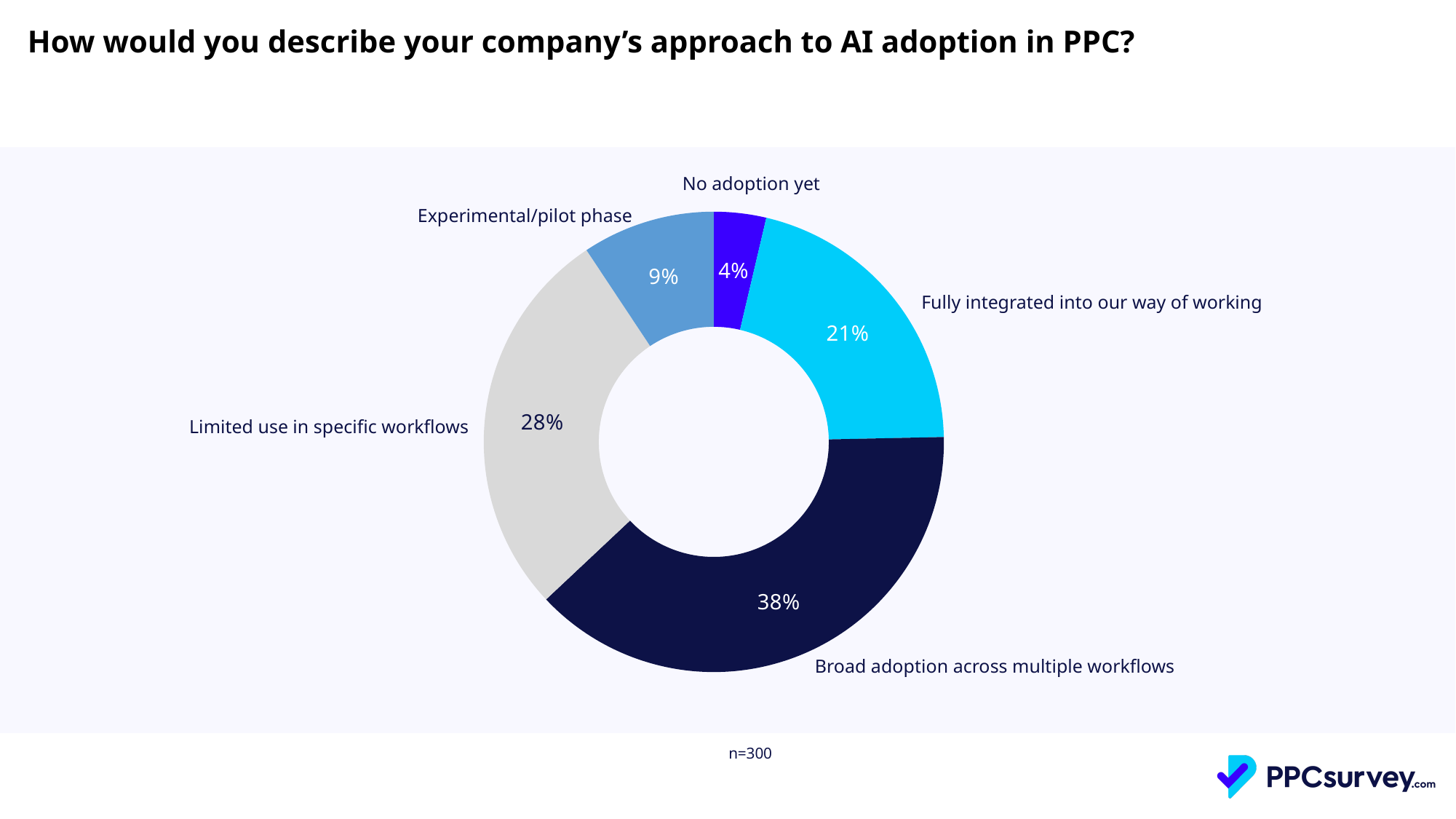
Which is larger: 'Experimental/pilot phase' or 'Fully integrated into our way of working'? Fully integrated into our way of working What percentage is shown for 'Fully integrated into our way of working'? 21% What kind of chart is shown on the slide? Donut chart What is the difference in percentage points between 'Broad adoption across multiple workflows' and 'Limited use in specific workflows'? 10 What percentage of respondents report 'No adoption yet'? 4% Which category has the smallest share of the chart? No adoption yet What is the sample size (n) shown on the slide? n=300 What percentage of respondents describe their approach as 'Broad adoption across multiple workflows'? 38% What is the combined share of 'Experimental/pilot phase' and 'No adoption yet'? 13% How many categories are shown in the chart? 5 Which category has the largest share of the chart? Broad adoption across multiple workflows What share is shown for 'Limited use in specific workflows'? 28%